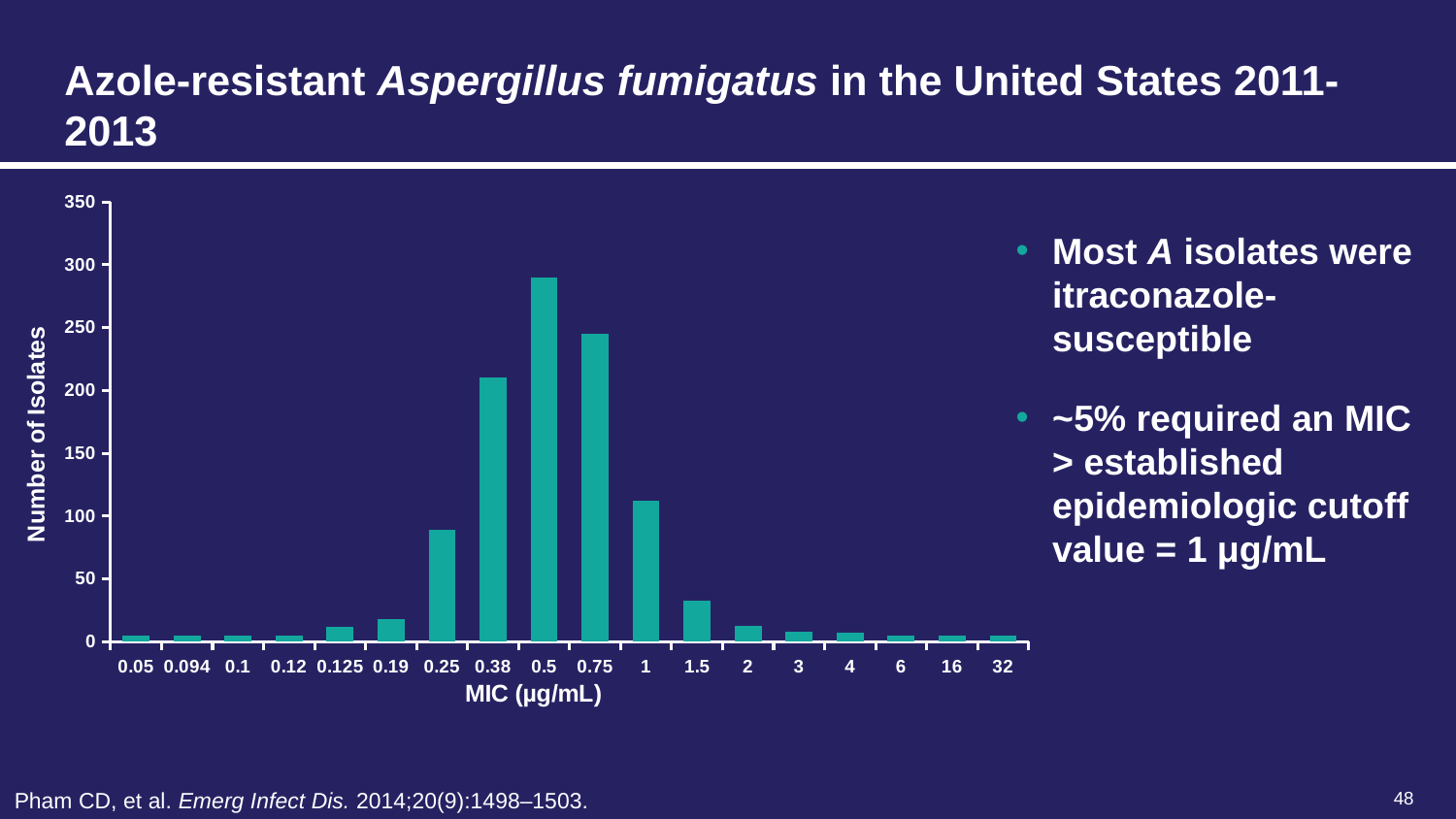
What kind of chart is shown on the slide? bar chart Is the number of isolates at MIC 1.5 greater or less than 50? less Which has more isolates, MIC 0.5 or MIC 0.75? 0.5 What is the label of the y axis? Number of Isolates Which has more isolates, MIC 0.38 or MIC 1? 0.38 Do the values rise or fall along the x axis from MIC 0.5 to MIC 32? fall Is the number of isolates at MIC 0.25 greater or less than 100? less Which MIC category has the highest number of isolates? 0.5 How many MIC categories are shown on the x axis? 18 Is the number of isolates at MIC 0.38 greater or less than 150? greater